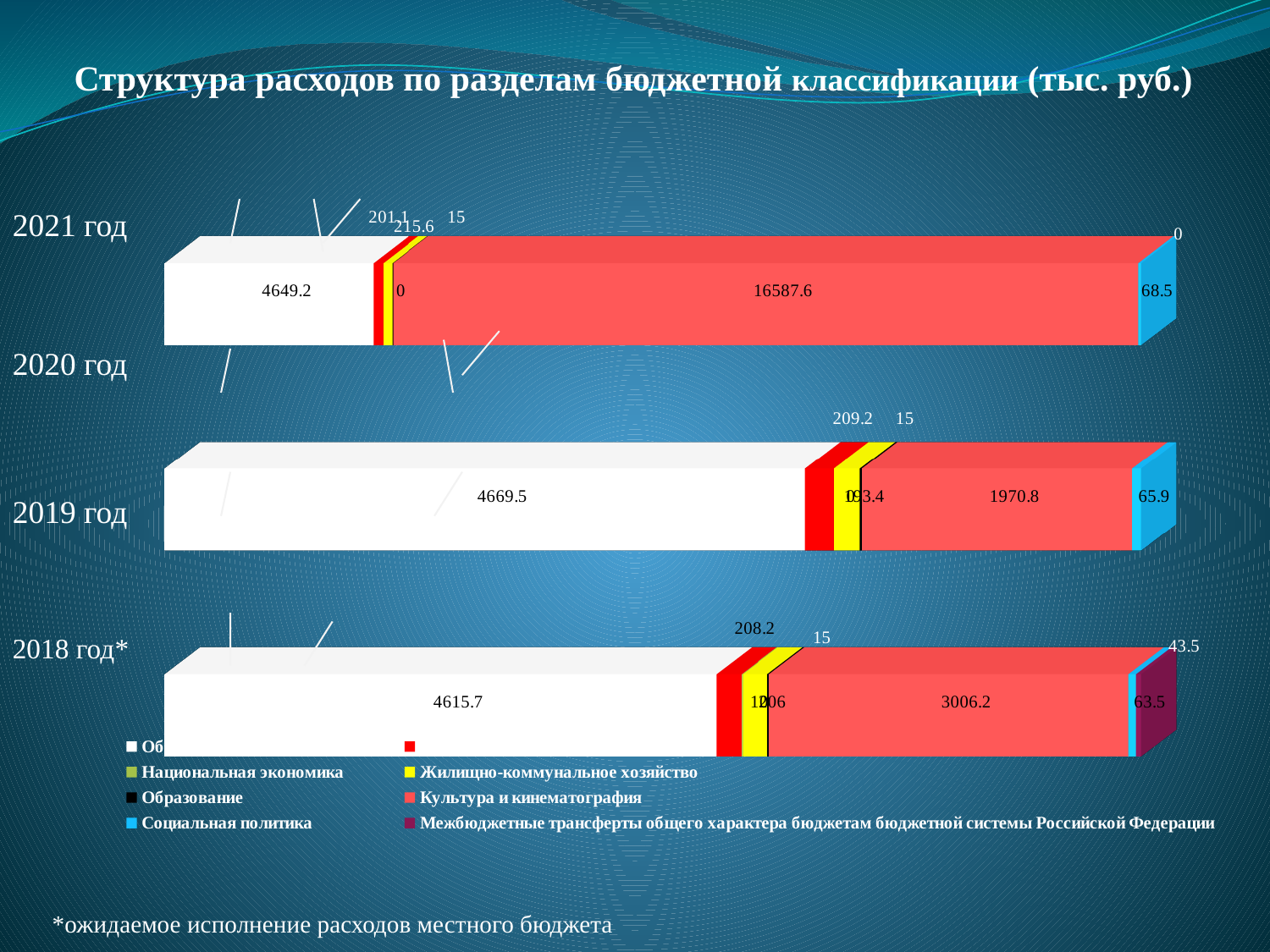
What is the difference between the Культура и кинематография values in the top bar and the middle bar? 14616.8 What is the value of the Культура и кинематография segment in the bottom bar (2018 год*)? 3006.2 What is the value of the Межбюджетные трансферты segment in the bottom bar (2018 год*)? 43.5 How many entries does the chart legend list? 8 What is the title of the chart on the slide? Структура расходов по разделам бюджетной классификации (тыс. руб.) What is the value of the Культура и кинематография segment in the top bar? 16587.6 What is the value of the Социальная политика segment in the top bar? 68.5 Which bar has the largest Культура и кинематография segment: the top, middle or bottom bar? Top bar What kind of chart is shown on the slide? Stacked bar chart What is the value of the Социальная политика segment in the middle bar? 65.9 What is the value of the Культура и кинематография segment in the middle bar? 1970.8 How many stacked bars are plotted in the chart? 3